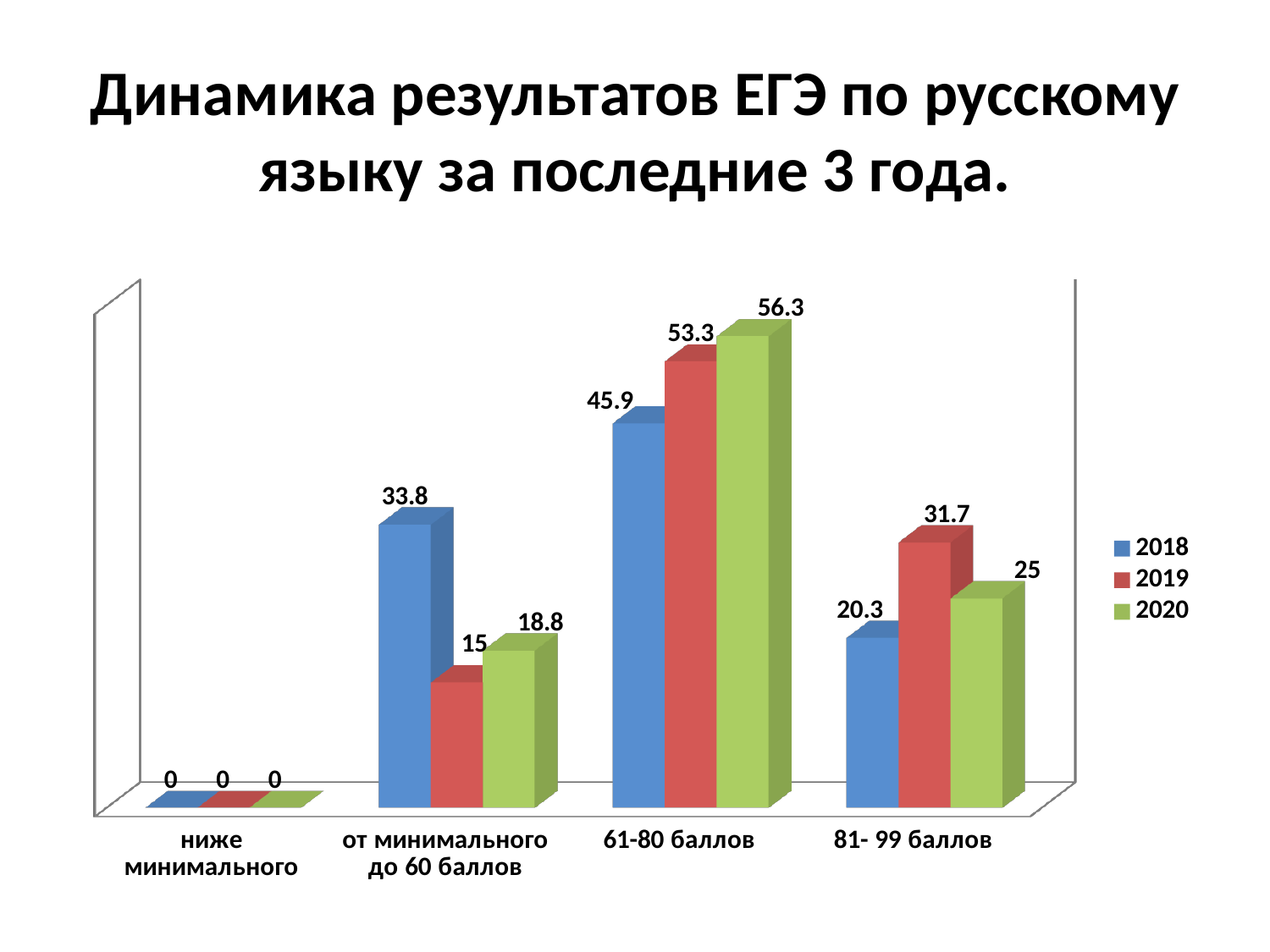
Which category has the highest value for the 2019 series? 61-80 баллов Which colour represents the 2020 series in the legend? green What is the difference between the 2020 and 2018 values in the "61-80 баллов" category? 10.4 Which category has the lowest value for the 2020 series? ниже минимального What kind of chart is shown on the slide? bar chart How many series does the legend list? 3 What is the value for 2020 in the "61-80 баллов" category? 56.3 What is the value for 2018 in the "от минимального до 60 баллов" category? 33.8 What is the difference between the 2018 and 2019 values in the "от минимального до 60 баллов" category? 18.8 In the "81- 99 баллов" category, which series has the larger value, 2019 or 2020? 2019 How many categories are shown on the x axis? 4 What is the value for 2019 in the "81- 99 баллов" category? 31.7